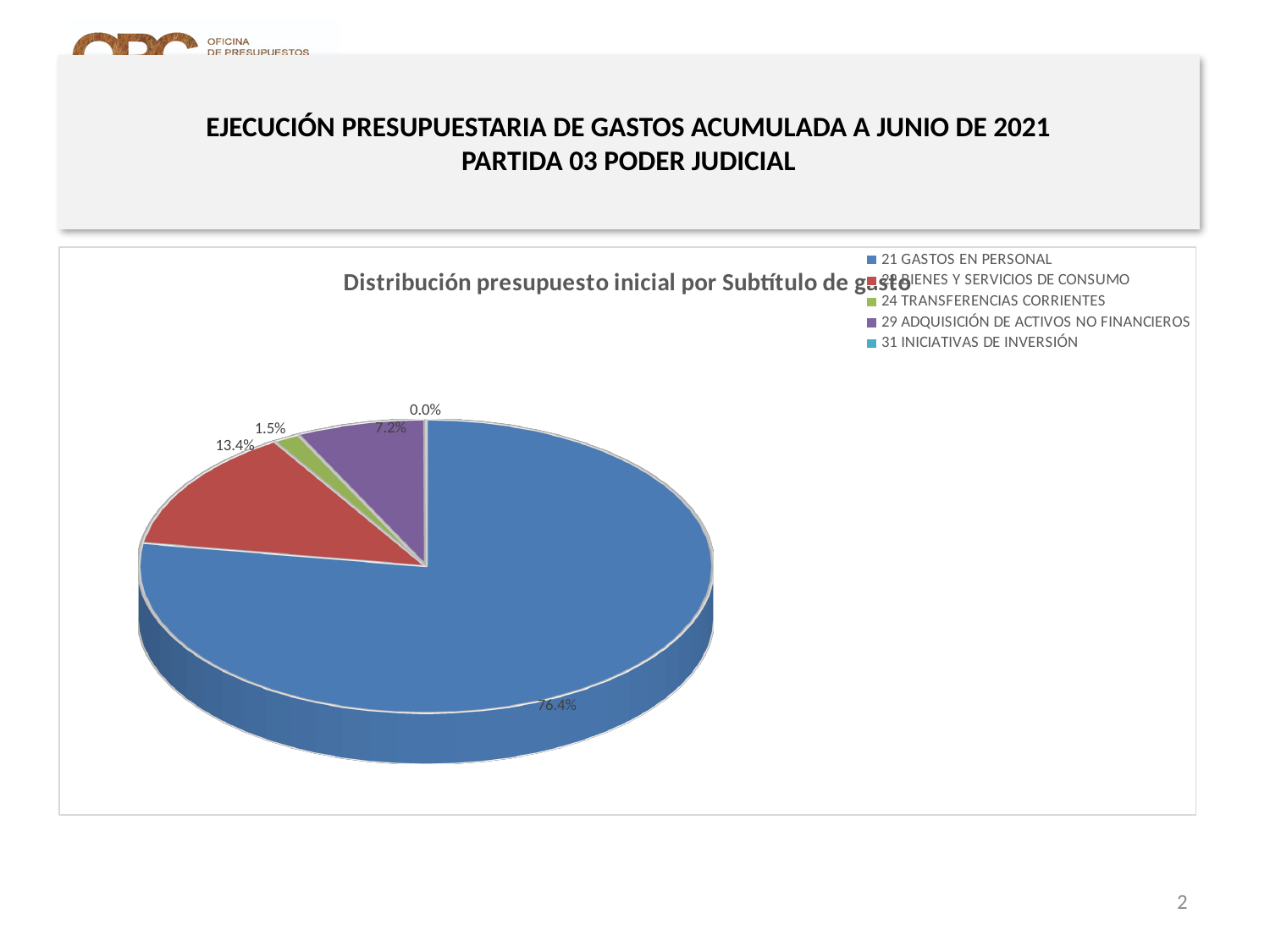
What is the title of the chart? Distribución presupuesto inicial por Subtítulo de gasto What percentage share does 29 ADQUISICIÓN DE ACTIVOS NO FINANCIEROS have in the pie chart? 7.2% What kind of chart is shown on the slide? Pie chart What percentage share does 24 TRANSFERENCIAS CORRIENTES have in the pie chart? 1.5% What percentage share does BIENES Y SERVICIOS DE CONSUMO have in the pie chart? 13.4% What percentage share does 31 INICIATIVAS DE INVERSIÓN have in the pie chart? 0.0% Which category has the smallest slice of the pie chart? 31 INICIATIVAS DE INVERSIÓN Which has a larger share: 29 ADQUISICIÓN DE ACTIVOS NO FINANCIEROS or 24 TRANSFERENCIAS CORRIENTES? 29 ADQUISICIÓN DE ACTIVOS NO FINANCIEROS How many categories does the legend of the pie chart list? 5 What percentage share does 21 GASTOS EN PERSONAL have in the pie chart? 76.4% What is the difference in percentage points between the share of 21 GASTOS EN PERSONAL and the share of BIENES Y SERVICIOS DE CONSUMO? 63.0 percentage points Which category has the largest slice of the pie chart? 21 GASTOS EN PERSONAL